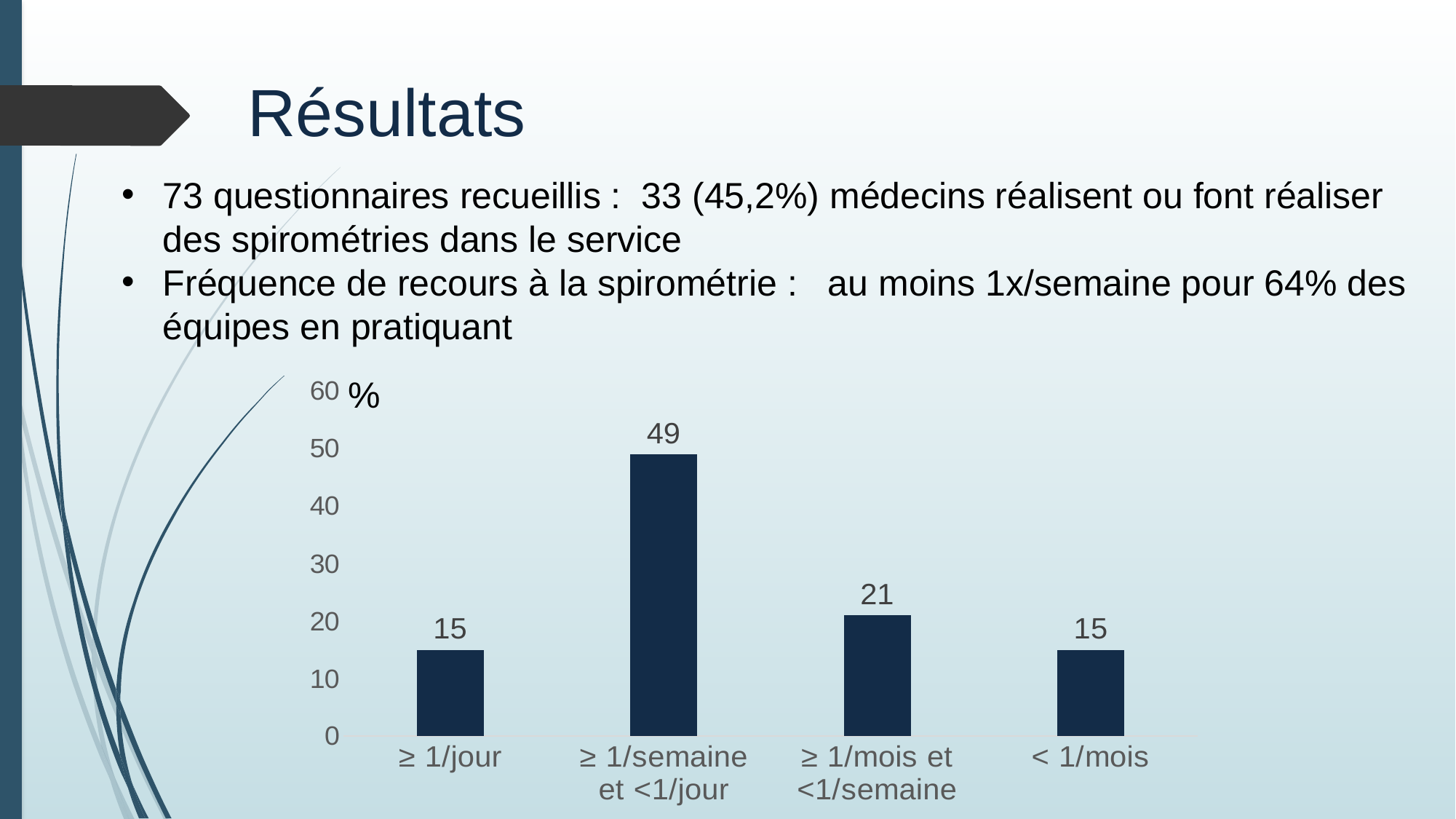
Which category has the highest value? ≥ 1/semaine et <1/jour How many categories are shown on the x axis of the chart? 4 Is the value for "≥ 1/semaine et <1/jour" greater or less than 40? greater Which is larger, the value for "≥ 1/mois et <1/semaine" or the value for "< 1/mois"? ≥ 1/mois et <1/semaine What unit label is shown at the top of the vertical axis? % What is the value for the "≥ 1/jour" category? 15 What is the value for the "< 1/mois" category? 15 What is the maximum value shown on the vertical axis? 60 What kind of chart is shown on the slide? bar chart What is the value for the "≥ 1/mois et <1/semaine" category? 21 What is the difference between the values for "≥ 1/semaine et <1/jour" and "≥ 1/mois et <1/semaine"? 28 What is the value for the "≥ 1/semaine et <1/jour" category? 49